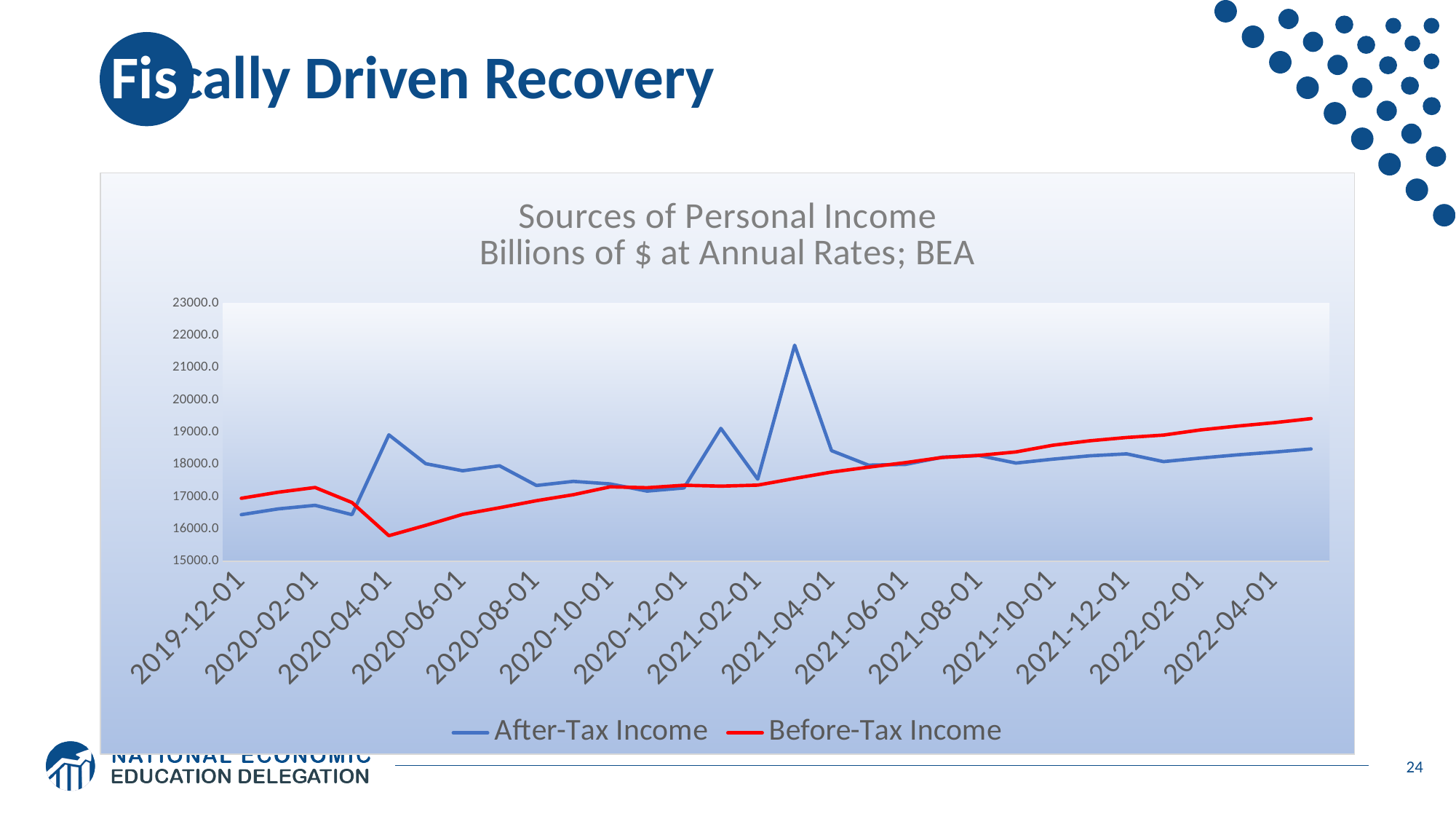
Which series reaches the highest value anywhere on the chart? After-Tax Income Which series reaches the lowest value anywhere on the chart? Before-Tax Income How many series does the legend list? 2 How many date labels are shown on the x axis? 15 Is the peak value of After-Tax Income greater or less than 20000.0? greater Does Before-Tax Income rise or fall from 2020-06-01 to 2022-04-01? Rise What is the title of the chart? Sources of Personal Income Billions of $ at Annual Rates; BEA At 2020-04-01, which is larger: After-Tax Income or Before-Tax Income? After-Tax Income What kind of chart is shown on the slide? Line chart Is the value of Before-Tax Income at 2020-04-01 greater or less than 16000.0? less Is the value of Before-Tax Income at 2022-04-01 greater or less than 19000.0? greater What are the two series named in the legend? After-Tax Income and Before-Tax Income